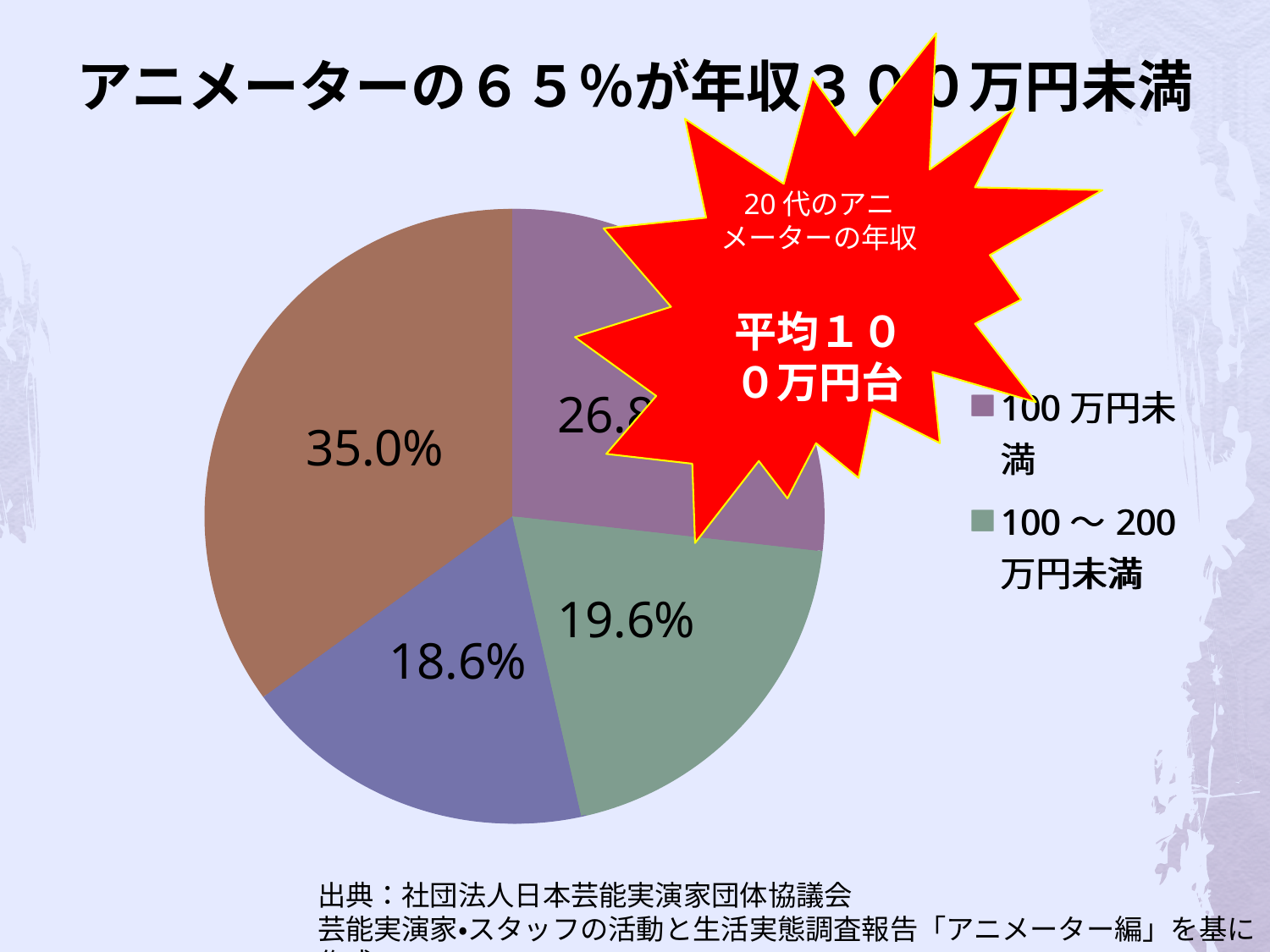
What is the difference between the 35.0% slice and the 19.6% slice? 15.4 percentage points What colour is the 100～200万円未満 slice in the pie chart? green What colour is the 100万円未満 slice in the pie chart? purple How many slices does the pie chart have? 4 What is the largest percentage shown on the pie chart? 35.0% What is the smallest percentage shown on the pie chart? 18.6% What share of the pie does the 100～200万円未満 slice represent? 19.6% What percentage is shown for the 100～200万円未満 slice? 19.6% What is the difference between the 35.0% slice and the 18.6% slice? 16.4 percentage points What kind of chart is shown on the slide? pie chart Is the share for 100万円未満 greater or less than 20%? greater Which is larger, the 19.6% slice or the 18.6% slice? the 19.6% slice